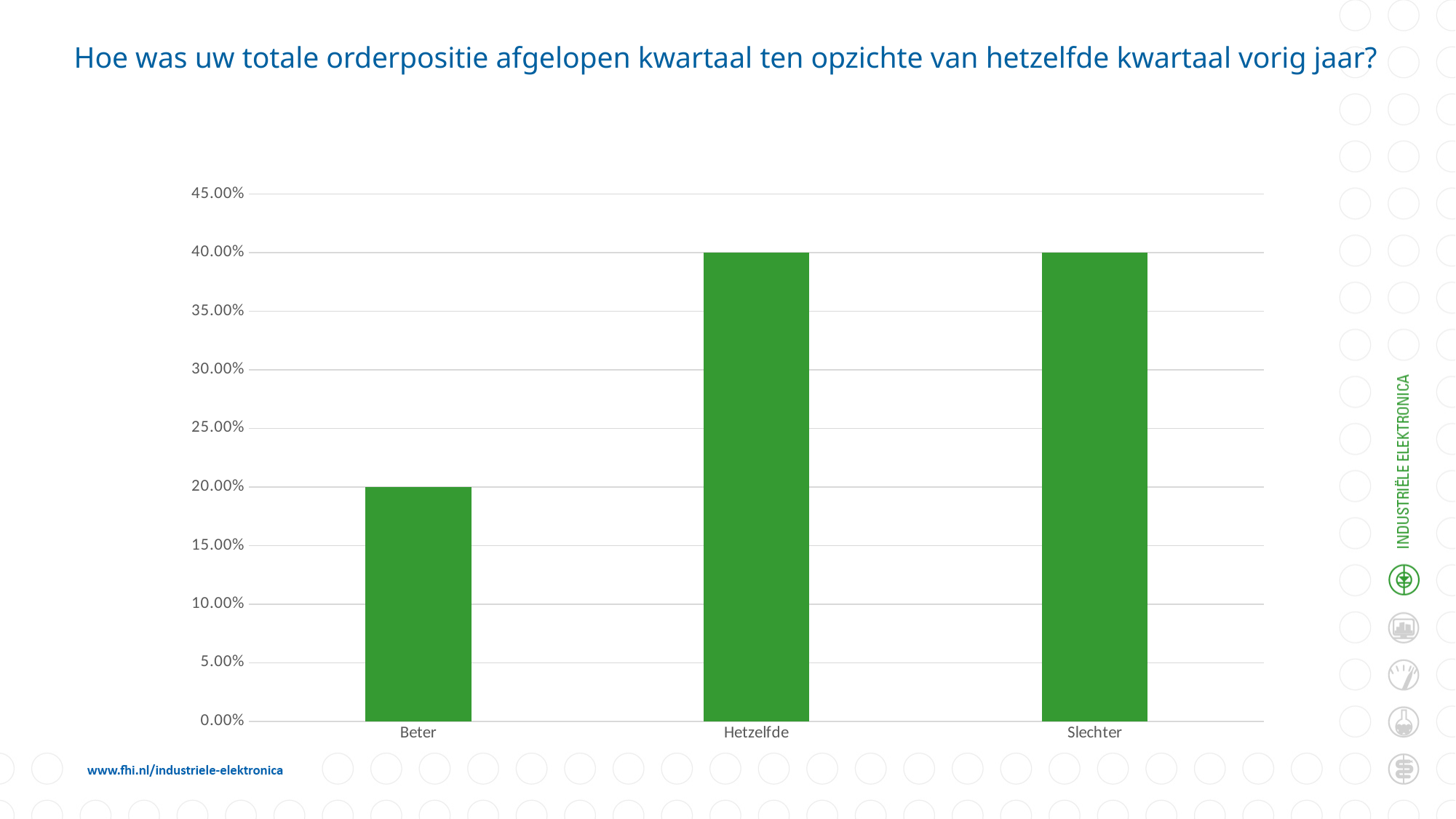
Is the value for Beter greater or less than 25.00%? less Which is larger, the value for Slechter or the value for Beter? Slechter What is the value for Beter? 20.00% How many categories are shown on the x axis? 3 Which category has the lowest value? Beter What is the value for Slechter? 40.00% Which is larger, the value for Beter or the value for Hetzelfde? Hetzelfde What is the difference between the values for Hetzelfde and Beter? 20.00% What is the value for Hetzelfde? 40.00% What kind of chart is shown on the slide? bar chart What is the title of the slide? Hoe was uw totale orderpositie afgelopen kwartaal ten opzichte van hetzelfde kwartaal vorig jaar? Is the value for Slechter greater or less than 35.00%? greater